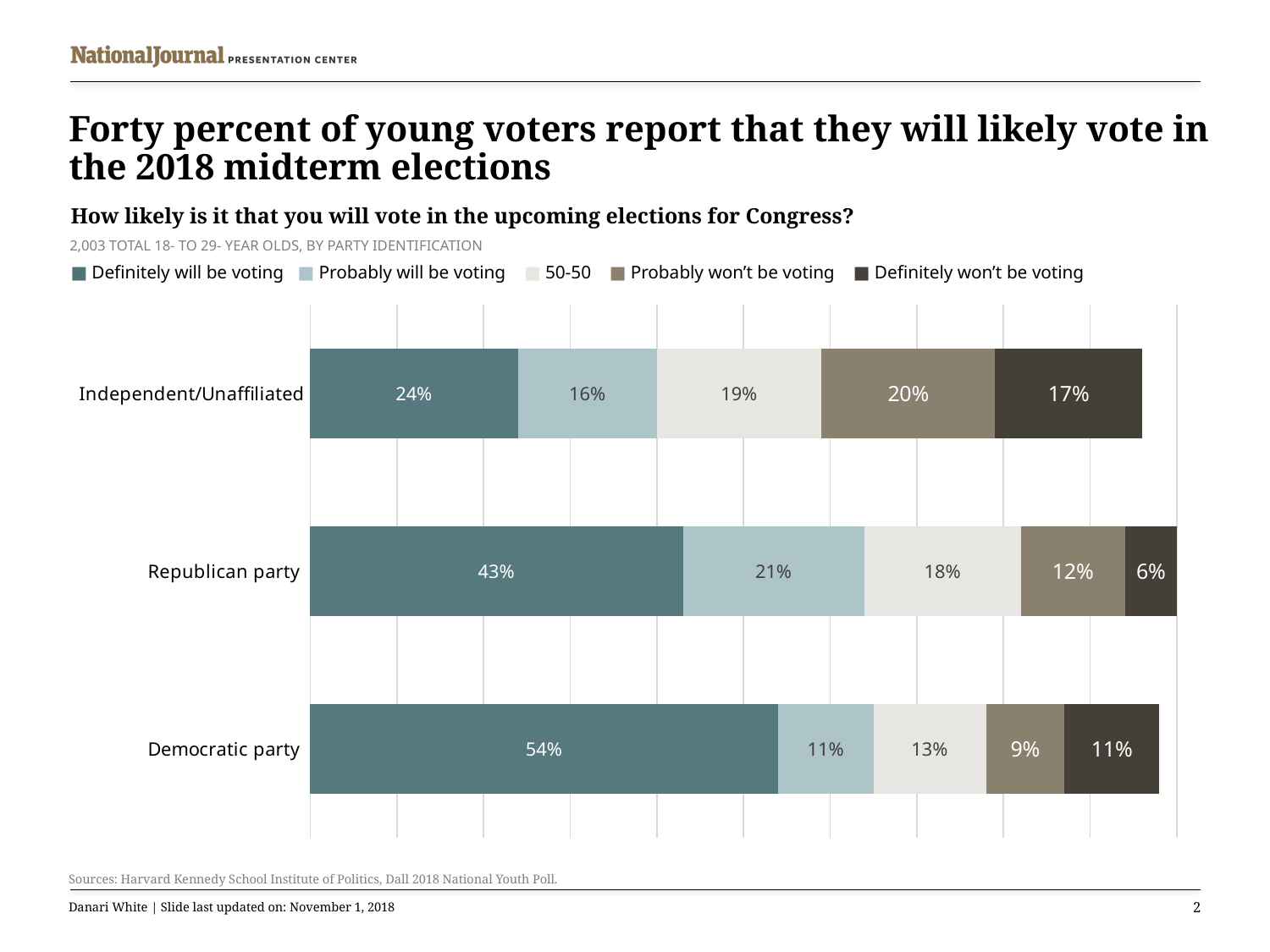
What percentage of Independent/Unaffiliated respondents answered 50-50? 19% How many party groups are shown in the chart? 3 What is the combined share of Democratic party respondents who definitely or probably will be voting? 65% How many series does the legend list? 5 What percentage of Republican party respondents say they definitely won't be voting? 6% Which party group has the highest share saying they definitely will be voting? Democratic party What percentage of Democratic party respondents say they definitely will be voting? 54% What percentage of Republican party respondents say they probably will be voting? 21% Which is larger: the share of Independent/Unaffiliated respondents who probably won't be voting or the share of Republican party respondents who probably won't be voting? Independent/Unaffiliated What kind of chart is shown on the slide? Stacked bar chart Which party group has the lowest share saying they definitely will be voting? Independent/Unaffiliated What is the difference between the Democratic party and Republican party shares saying they definitely will be voting? 11 percentage points